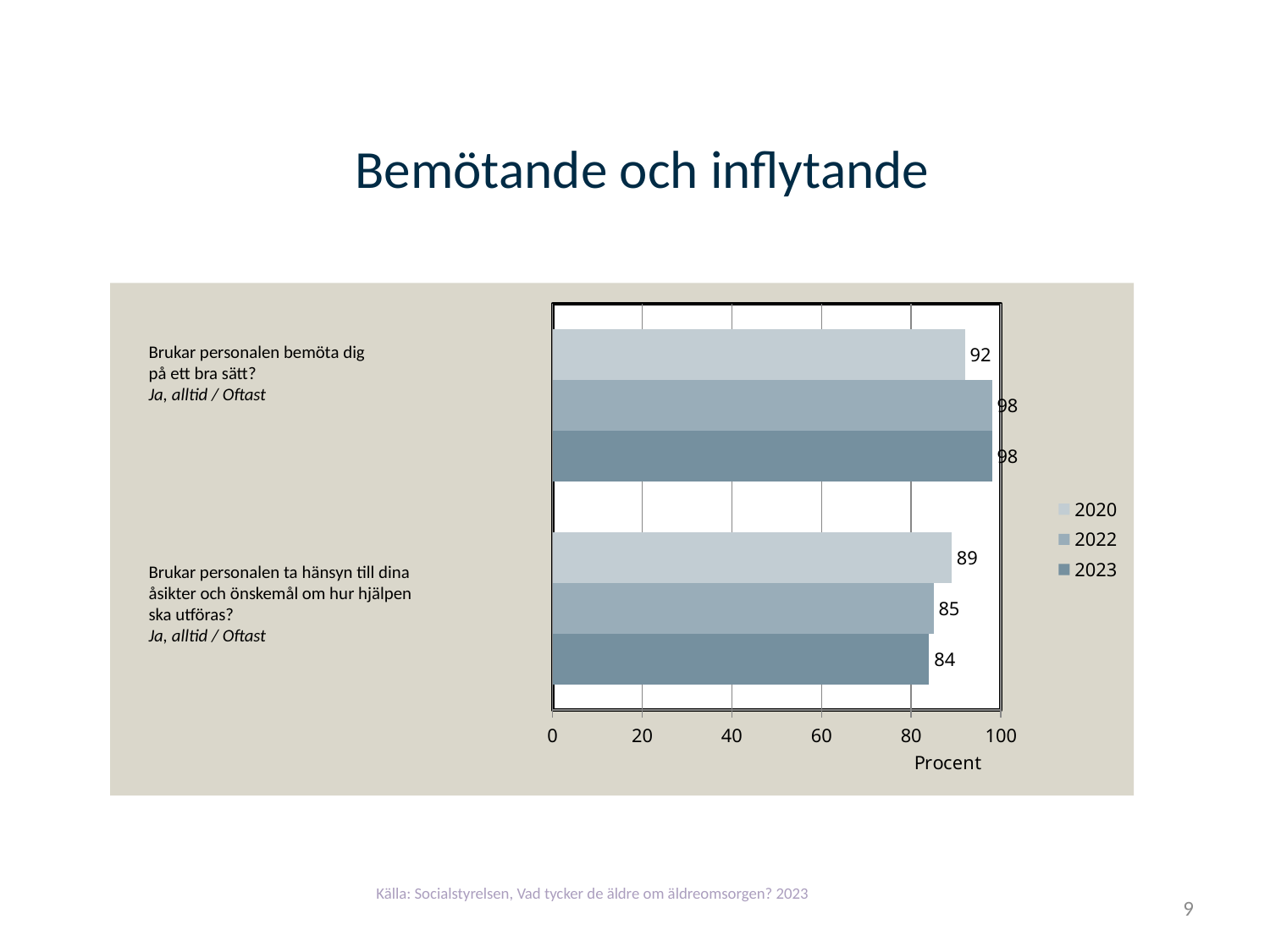
What is the label on the horizontal axis of the chart? Procent Which year has the highest value for "Brukar personalen ta hänsyn till dina åsikter och önskemål om hur hjälpen ska utföras?"? 2020 What is the difference between the 2022 and 2020 values for "Brukar personalen bemöta dig på ett bra sätt?"? 6 Which is larger: the 2023 value for "Brukar personalen bemöta dig på ett bra sätt?" or the 2023 value for "Brukar personalen ta hänsyn till dina åsikter och önskemål om hur hjälpen ska utföras?"? Brukar personalen bemöta dig på ett bra sätt? What is the 2023 value for "Brukar personalen ta hänsyn till dina åsikter och önskemål om hur hjälpen ska utföras?"? 84 How many series does the legend list? 3 What is the 2020 value for "Brukar personalen bemöta dig på ett bra sätt?"? 92 Which year has the lowest value for "Brukar personalen bemöta dig på ett bra sätt?"? 2020 What is the 2023 value for "Brukar personalen bemöta dig på ett bra sätt?"? 98 What is the difference between the 2020 and 2023 values for "Brukar personalen ta hänsyn till dina åsikter och önskemål om hur hjälpen ska utföras?"? 5 What is the 2022 value for "Brukar personalen ta hänsyn till dina åsikter och önskemål om hur hjälpen ska utföras?"? 85 What kind of chart is shown on the slide? bar chart